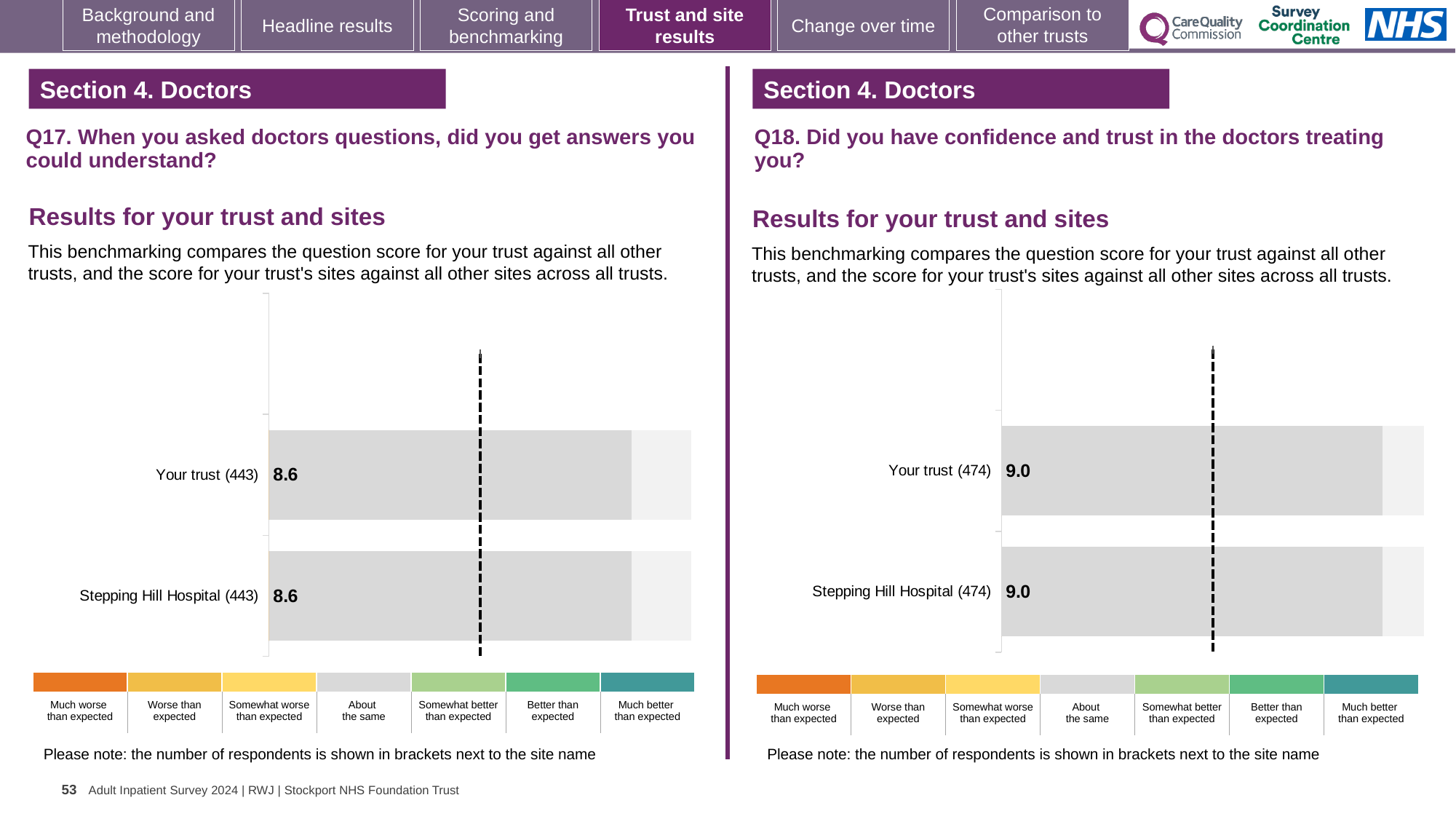
Is the score for Your trust on the Q18 chart (right) larger than the score for Your trust on the Q17 chart (left)? Yes On the Q18 chart (right), what is the score for Stepping Hill Hospital? 9.0 On the Q17 chart (left), how many respondents are shown in brackets next to Your trust? 443 On the Q18 chart (right), what is the score for Your trust? 9.0 On the Q17 chart (left), what is the score for Your trust? 8.6 On the Q17 chart (left), what is the score for Stepping Hill Hospital? 8.6 On the Q18 chart (right), what is the difference between the score for Your trust and the score for Stepping Hill Hospital? 0.0 On the Q18 chart (right), how many respondents are shown in brackets next to Stepping Hill Hospital? 474 What kind of chart is used on the Q17 chart (left)? Bar chart On the Q17 chart (left), what is the difference between the score for Your trust and the score for Stepping Hill Hospital? 0.0 How many bars are plotted on the Q18 chart (right)? 2 How many bars are plotted on the Q17 chart (left)? 2